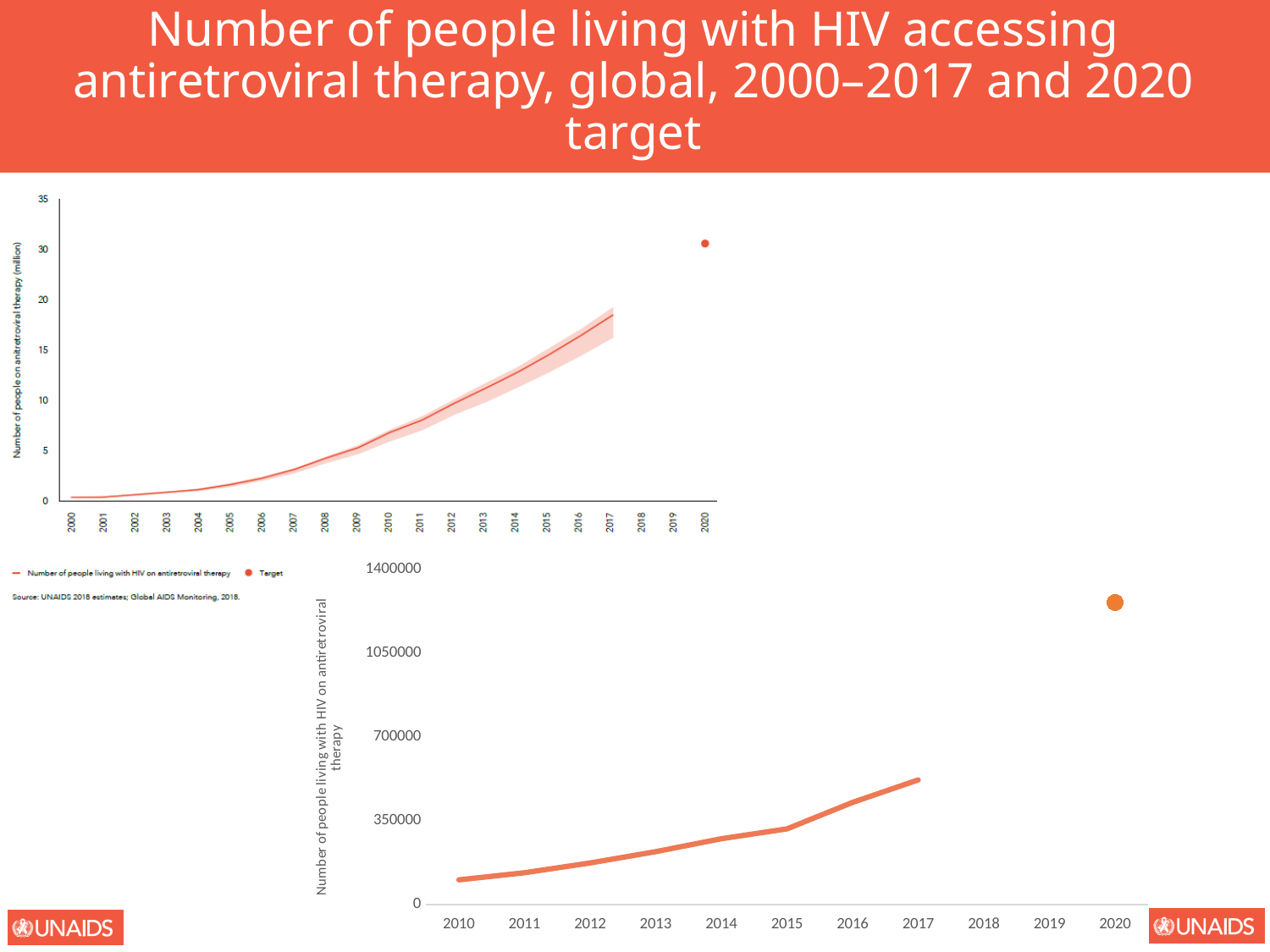
In the top chart, is the 2020 target greater or less than 25 million? greater In the top chart, is the value for 2017 greater or less than 20 million? less In the top chart, is the value for 2017 greater or less than 15 million? greater How many entries does the legend of the top chart list? 2 In the top chart, does the number of people on antiretroviral therapy rise or fall from 2000 to 2017? rise How many year labels are shown on the x axis of the top chart? 21 What kind of chart is the top chart on the slide? line chart What is the y-axis label of the top chart? Number of people on antiretroviral therapy (million)